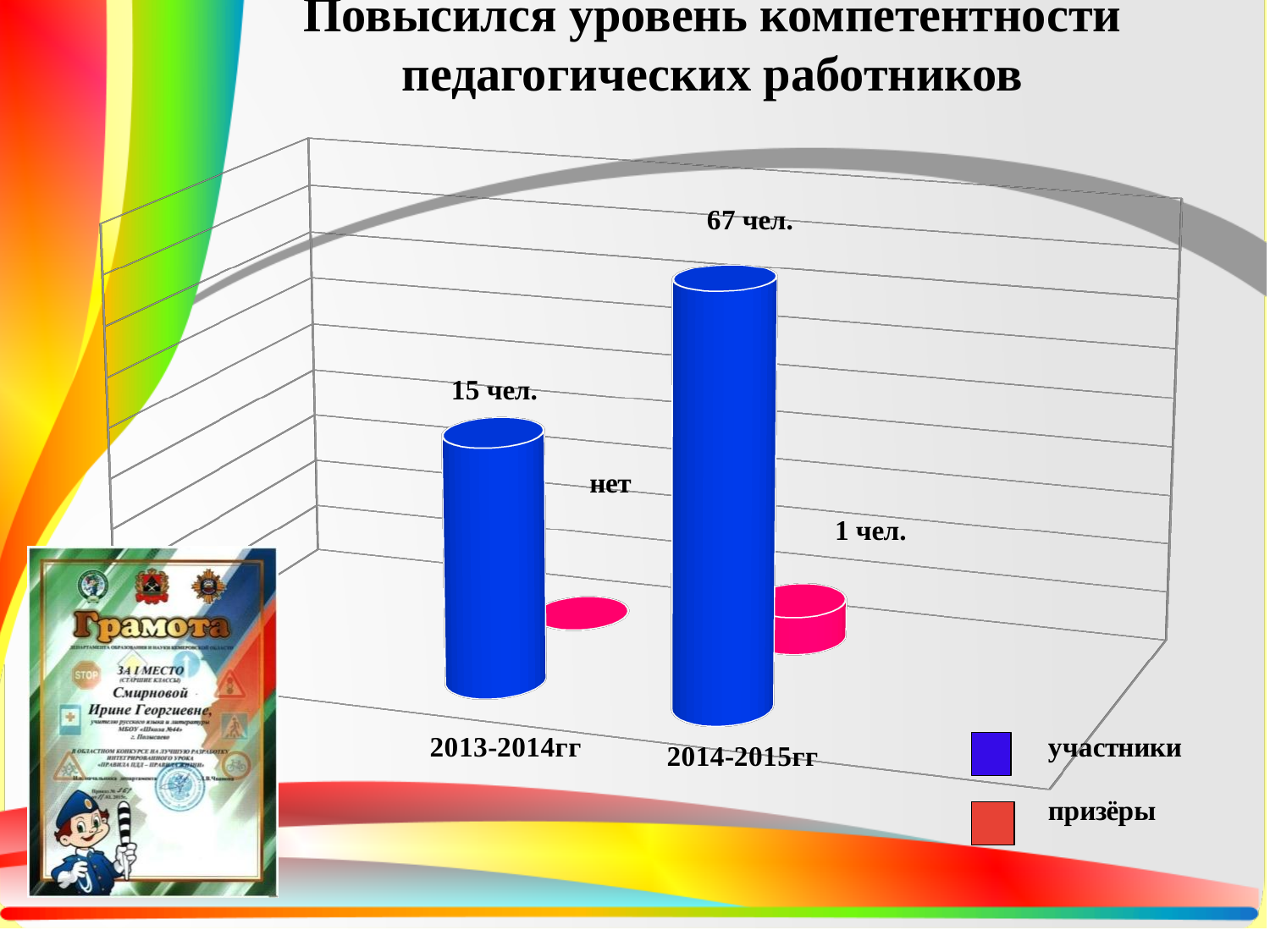
How many участники were there in 2013-2014гг? 15 чел. Which year had the lower number of участники? 2013-2014гг What is the data label for призёры in 2013-2014гг? нет Which is larger: участники in 2014-2015гг or участники in 2013-2014гг? участники in 2014-2015гг How many призёры were there in 2014-2015гг? 1 чел. How many categories (year periods) are shown on the x axis? 2 Which colour represents участники in the legend? blue By how many people did the number of участники increase from 2013-2014гг to 2014-2015гг? 52 How many series does the legend list? 2 What kind of chart is shown on the slide? bar chart Which year had the higher number of участники? 2014-2015гг How many участники were there in 2014-2015гг? 67 чел.